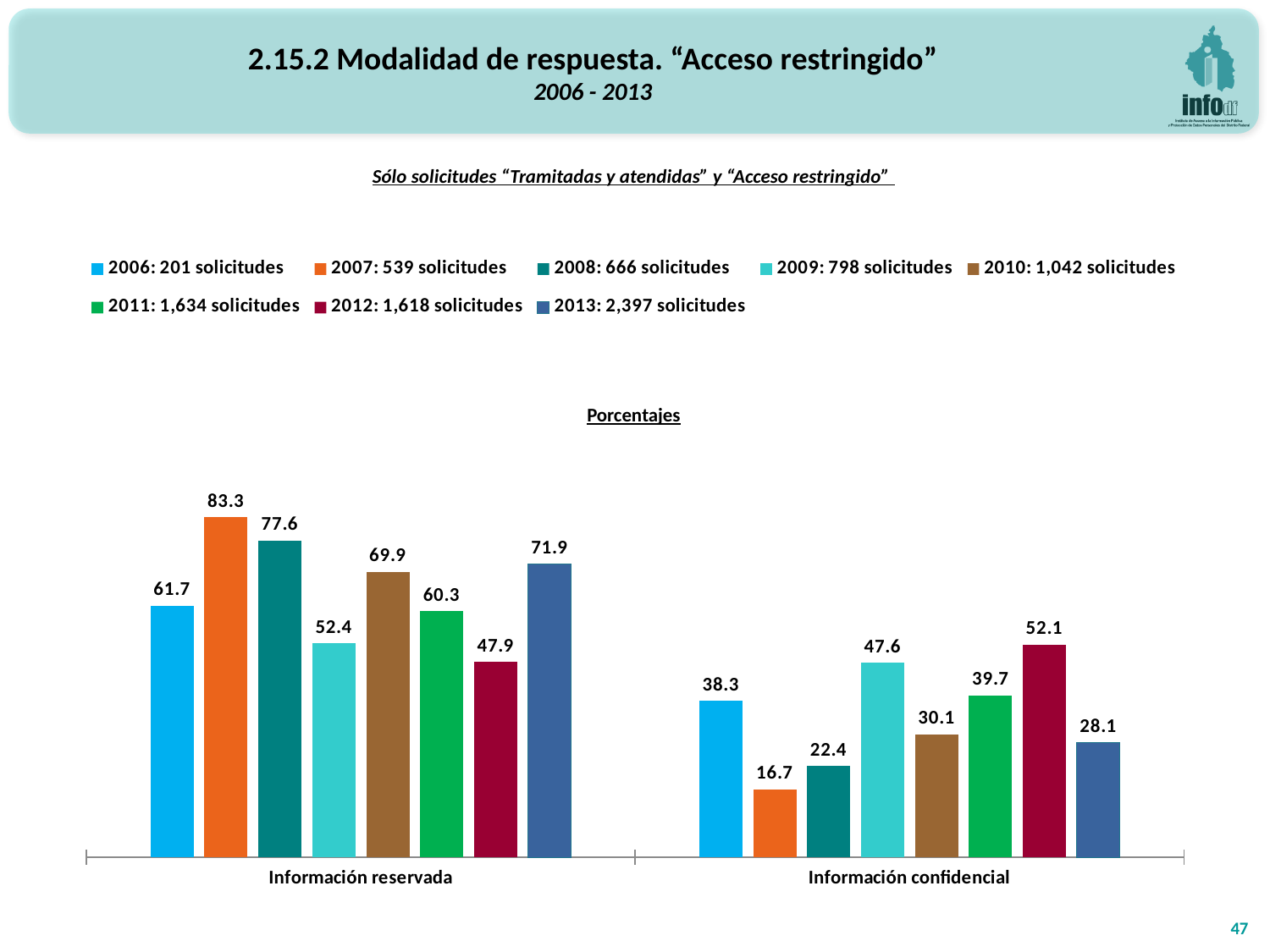
Which is larger: the 2009 value for "Información reservada" or the 2009 value for "Información confidencial"? Información reservada What is the difference between the 2006 values for "Información reservada" and "Información confidencial"? 23.4 What is the value for 2007 in the "Información reservada" group? 83.3 What is the difference between the 2008 and 2010 values in the "Información confidencial" group? 7.7 What kind of chart is shown on the slide? Bar chart How many categories are shown on the x axis? 2 Which year has the highest value in the "Información reservada" group? 2007 Which year has the lowest value in the "Información confidencial" group? 2007 According to the legend, how many solicitudes were there in 2013? 2,397 How many series does the legend list? 8 What is the value for 2012 in the "Información confidencial" group? 52.1 What is the value for 2013 in the "Información reservada" group? 71.9